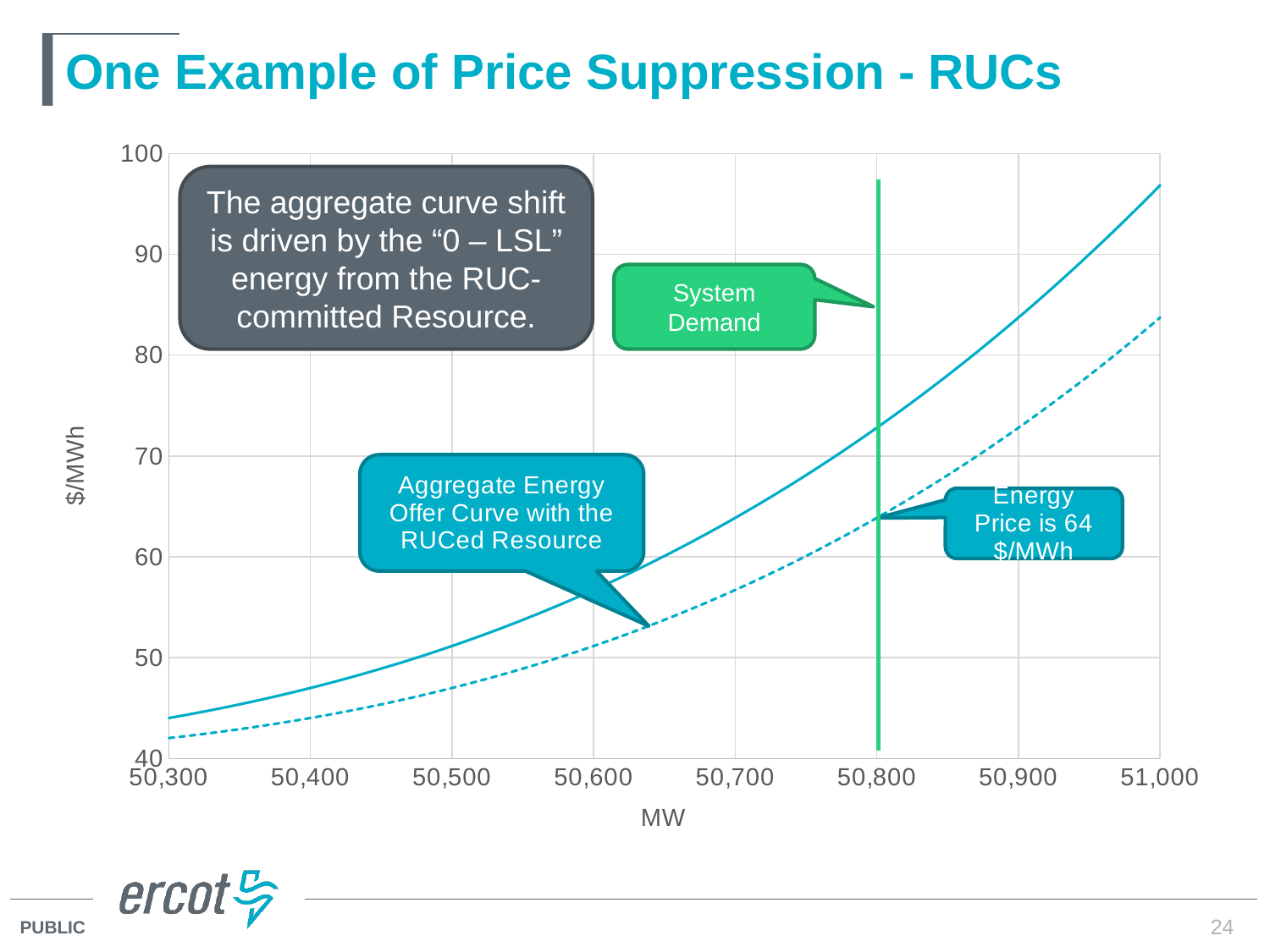
What is the label of the x axis? MW At the System Demand line, which curve is higher: the solid curve or the dashed curve? the solid curve What kind of chart is shown on the slide? line chart Is the value of the solid curve at 51,000 MW greater or less than 90? greater Is the value of the solid curve at 50,800 MW greater or less than 70? greater Is the value of the dashed curve at 51,000 MW greater or less than 90? less What is the label of the y axis? $/MWh How many curves are plotted on the chart (excluding the vertical System Demand line)? 2 What is the energy price at the System Demand level, according to the callout on the chart? 64 $/MWh Do the energy offer curves rise or fall as MW increases along the x axis? rise At what MW value is the vertical System Demand line drawn? 50,800